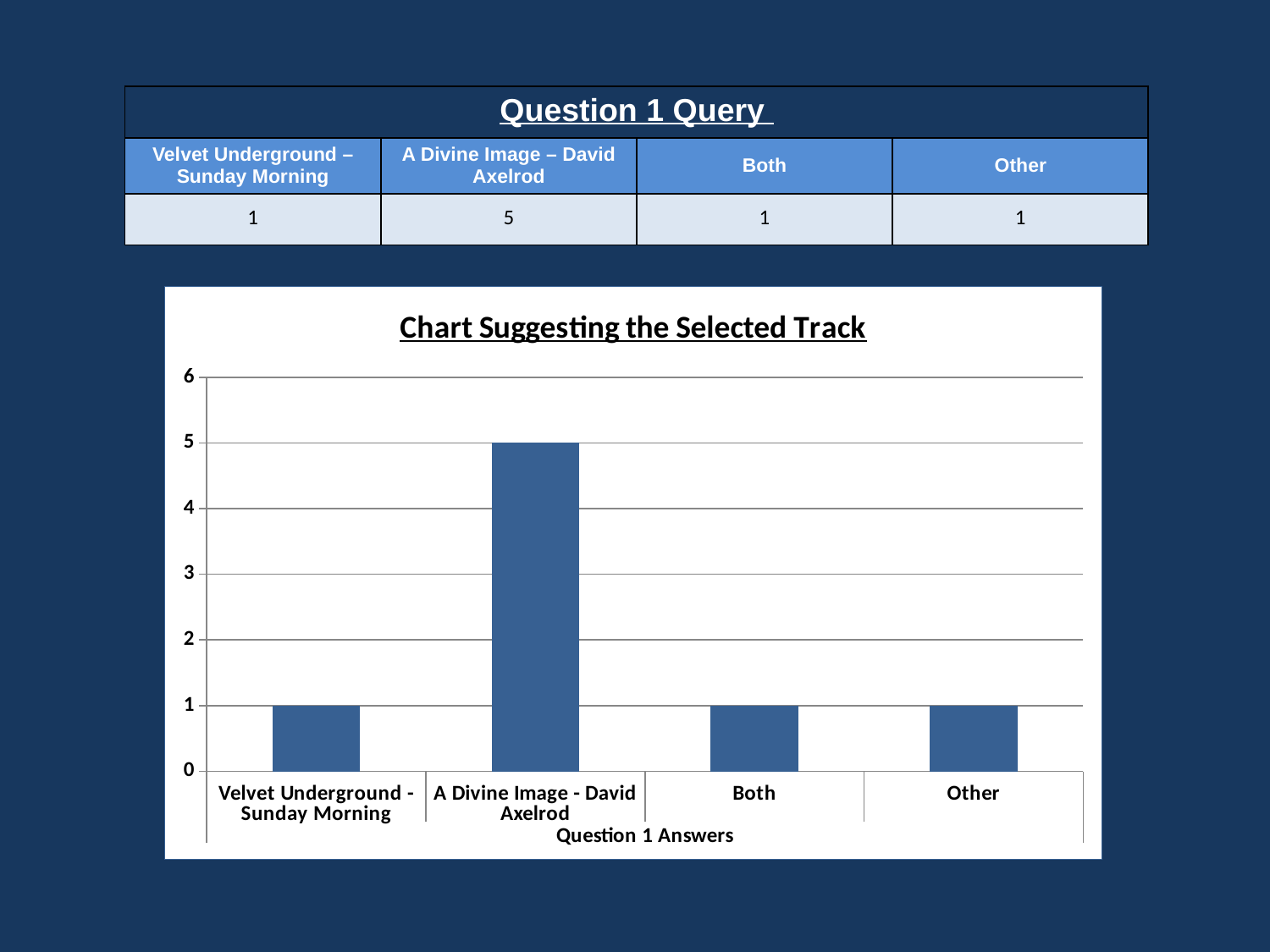
Is the value for A Divine Image - David Axelrod greater or less than 3? greater What kind of chart is shown on the slide? bar chart What is the label of the x axis of the chart? Question 1 Answers What is the title of the chart? Chart Suggesting the Selected Track What is the value for A Divine Image - David Axelrod? 5 How many categories are shown on the x axis of the chart? 4 What is the difference between the values for A Divine Image - David Axelrod and Both? 4 Which is larger, the value for A Divine Image - David Axelrod or the value for Other? A Divine Image - David Axelrod What is the value for Other? 1 What is the value for Both? 1 What is the value for Velvet Underground - Sunday Morning? 1 Which category has the highest value? A Divine Image - David Axelrod